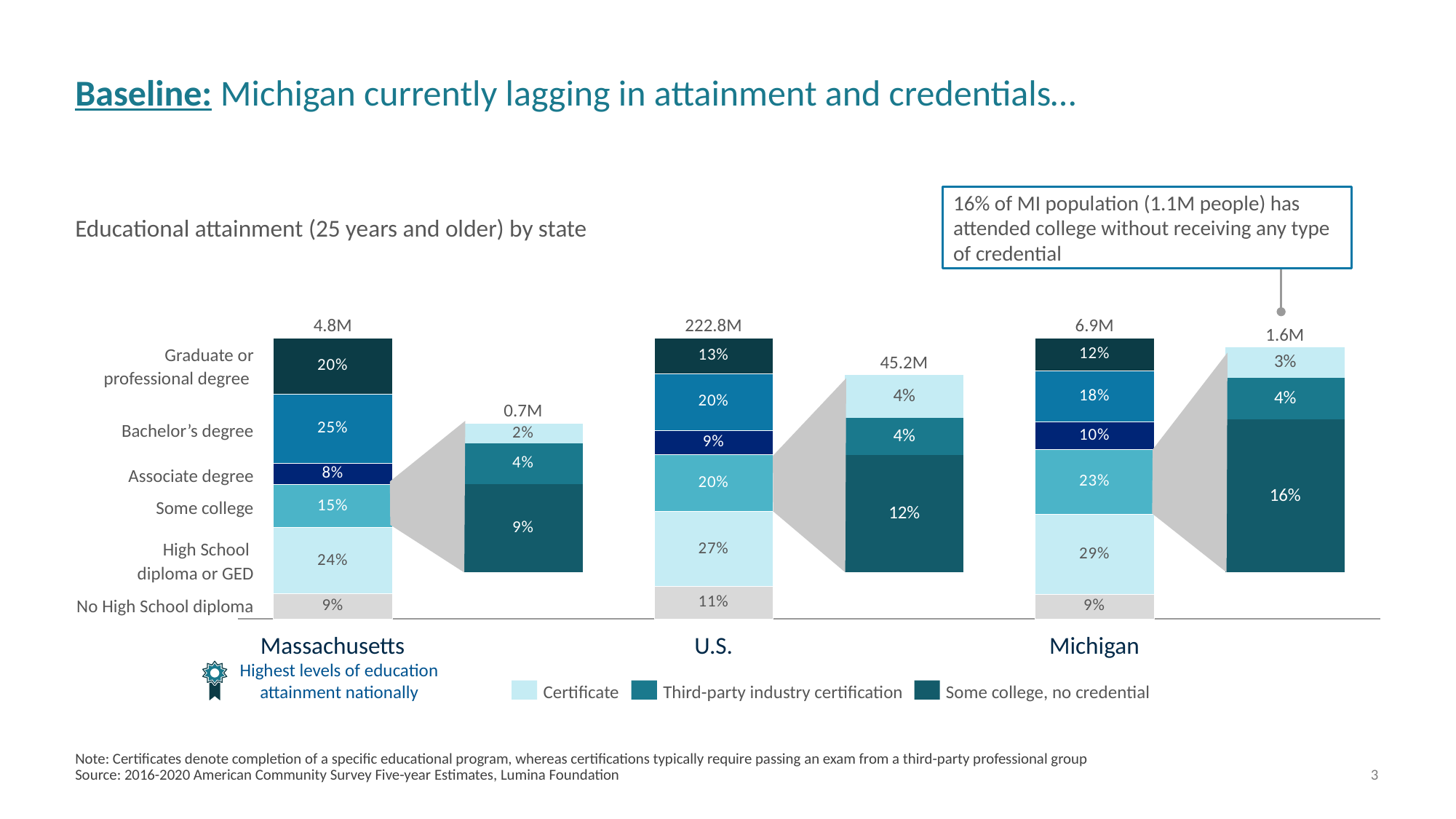
What population total is shown above the Michigan bar? 6.9M What population total is shown above the Michigan 'Some college' breakout bar? 1.6M What percentage of the U.S. population holds a certificate, according to the breakout bar? 4% What kind of chart is shown on the slide? Stacked bar chart Which state or region has the lowest share with a bachelor's degree? Michigan What percentage of the U.S. population has a high school diploma or GED as their highest attainment? 27% Which has a larger 'Some college' share, Michigan or the U.S.? Michigan Which state or region has the highest share with a graduate or professional degree? Massachusetts What percentage of Massachusetts' population has a bachelor's degree? 25% How many percentage points higher is Michigan's 'Some college, no credential' share than Massachusetts'? 7 percentage points How many entries does the legend at the bottom of the chart list? 3 What percentage of Michigan's population (25 years and older) has a graduate or professional degree? 12%